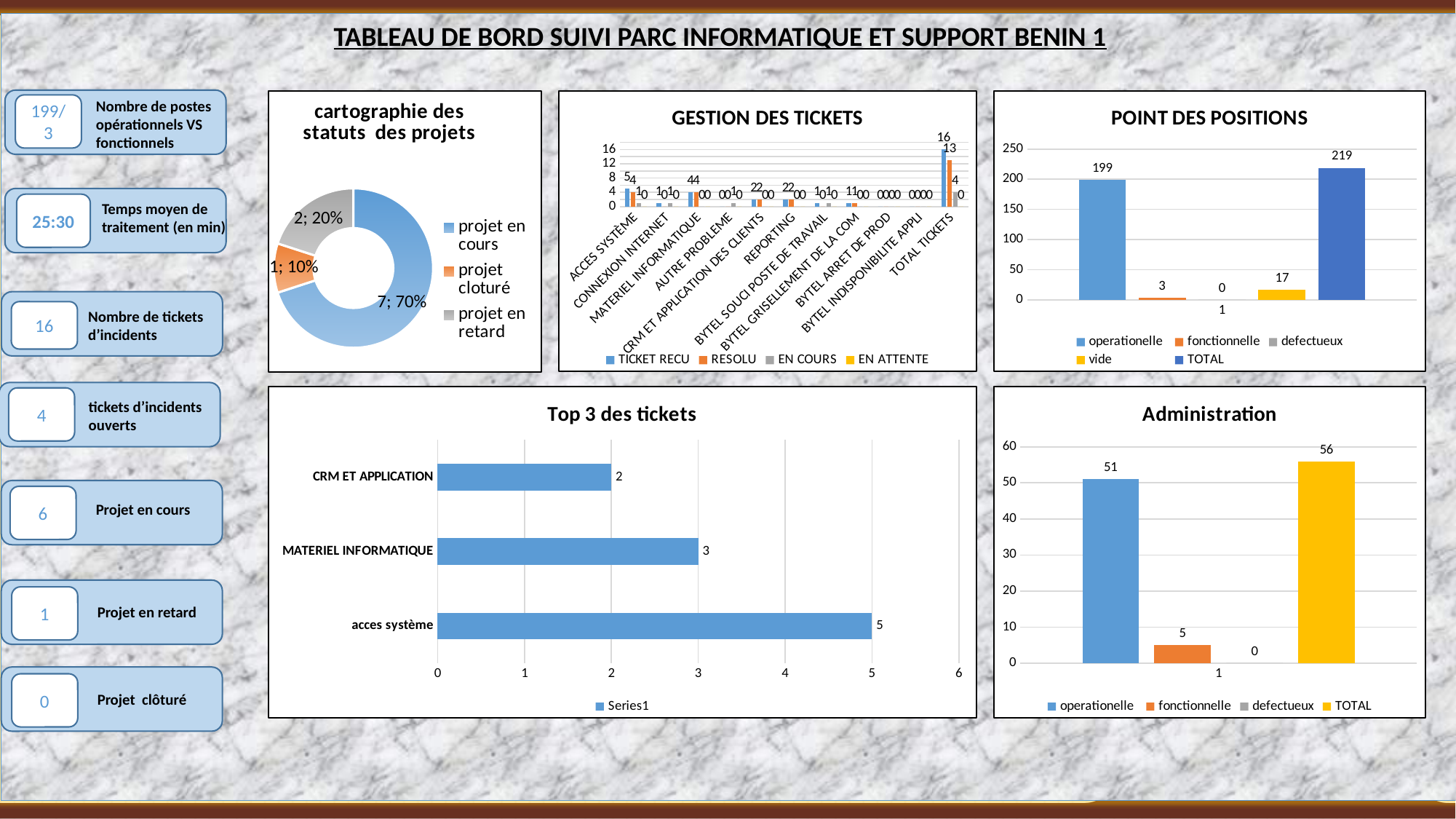
In the 'Administration' chart, how many entries does the legend list? 4 In the 'POINT DES POSITIONS' chart, what is the value for TOTAL? 219 In the 'POINT DES POSITIONS' chart, what is the value for operationelle? 199 In the 'GESTION DES TICKETS' chart, what is the TICKET RECU value for TOTAL TICKETS? 16 In the 'cartographie des statuts des projets' chart, what is the value for 'projet en retard'? 2 In the 'POINT DES POSITIONS' chart, what is the difference between TOTAL and operationelle? 20 In the 'Top 3 des tickets' chart, what is the value for acces système? 5 In the 'Top 3 des tickets' chart, which category has the highest value? acces système In the 'cartographie des statuts des projets' chart, what share does 'projet en cours' have? 70% In the 'Administration' chart, what is the value for operationelle? 51 In the 'Administration' chart, which category has the lowest value? defectueux What kind of chart is 'Top 3 des tickets'? bar chart